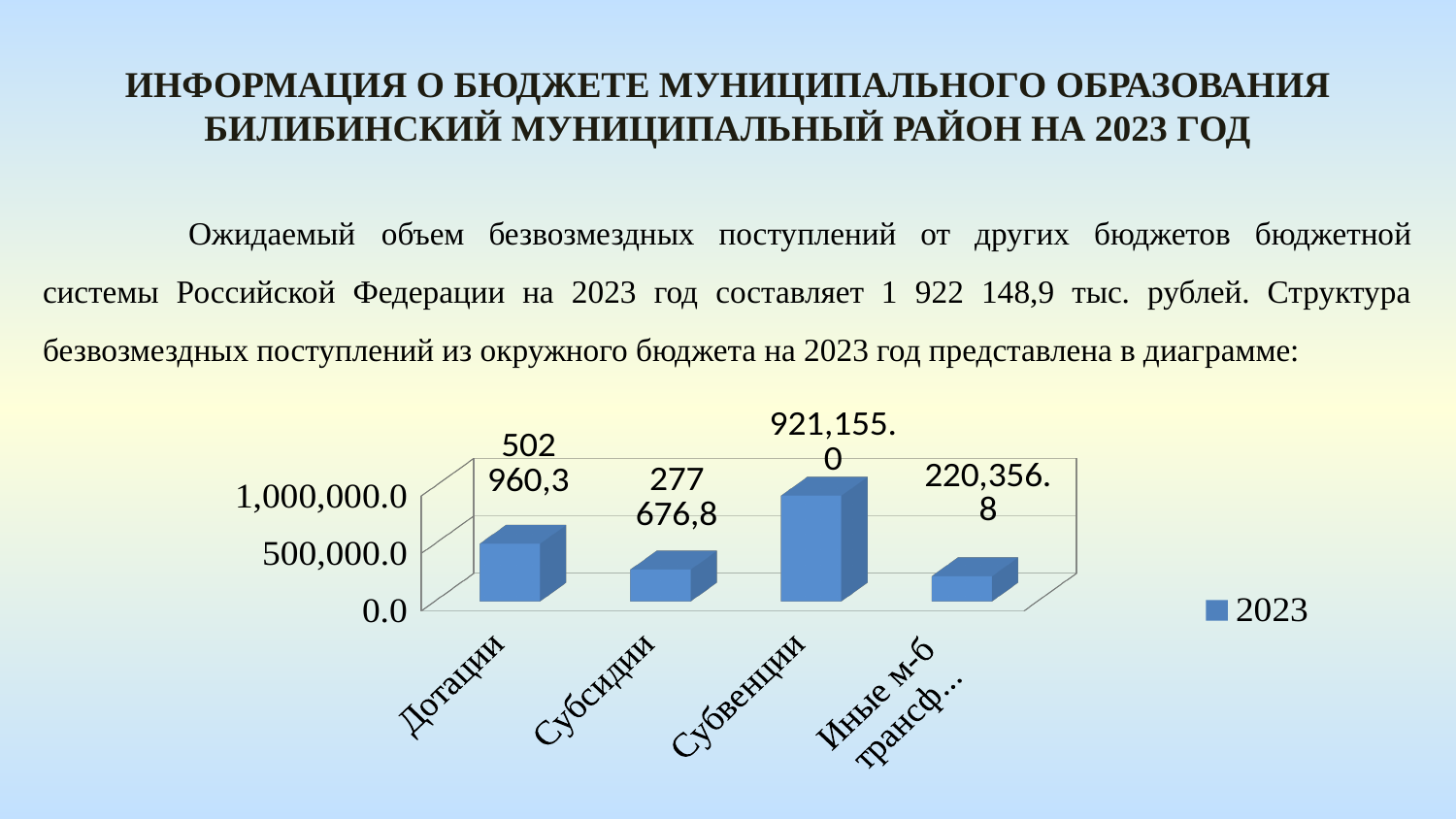
Which category has the highest value? Субвенции What is the value for Субсидии? 277 676,8 What is the value for Субвенции? 921,155.0 Which is larger, the value for Дотации or the value for Субсидии? Дотации What is the value for Дотации? 502 960,3 What is the difference between the values for Субвенции and Субсидии? 643,478.2 What kind of chart is shown on the slide? bar chart What entry does the chart legend list? 2023 Which category has the lowest value? Иные м-б трансф... Is the value for Субвенции greater or less than 500,000.0? greater How many categories are shown on the chart? 4 Is the value for Субсидии greater or less than 500,000.0? less